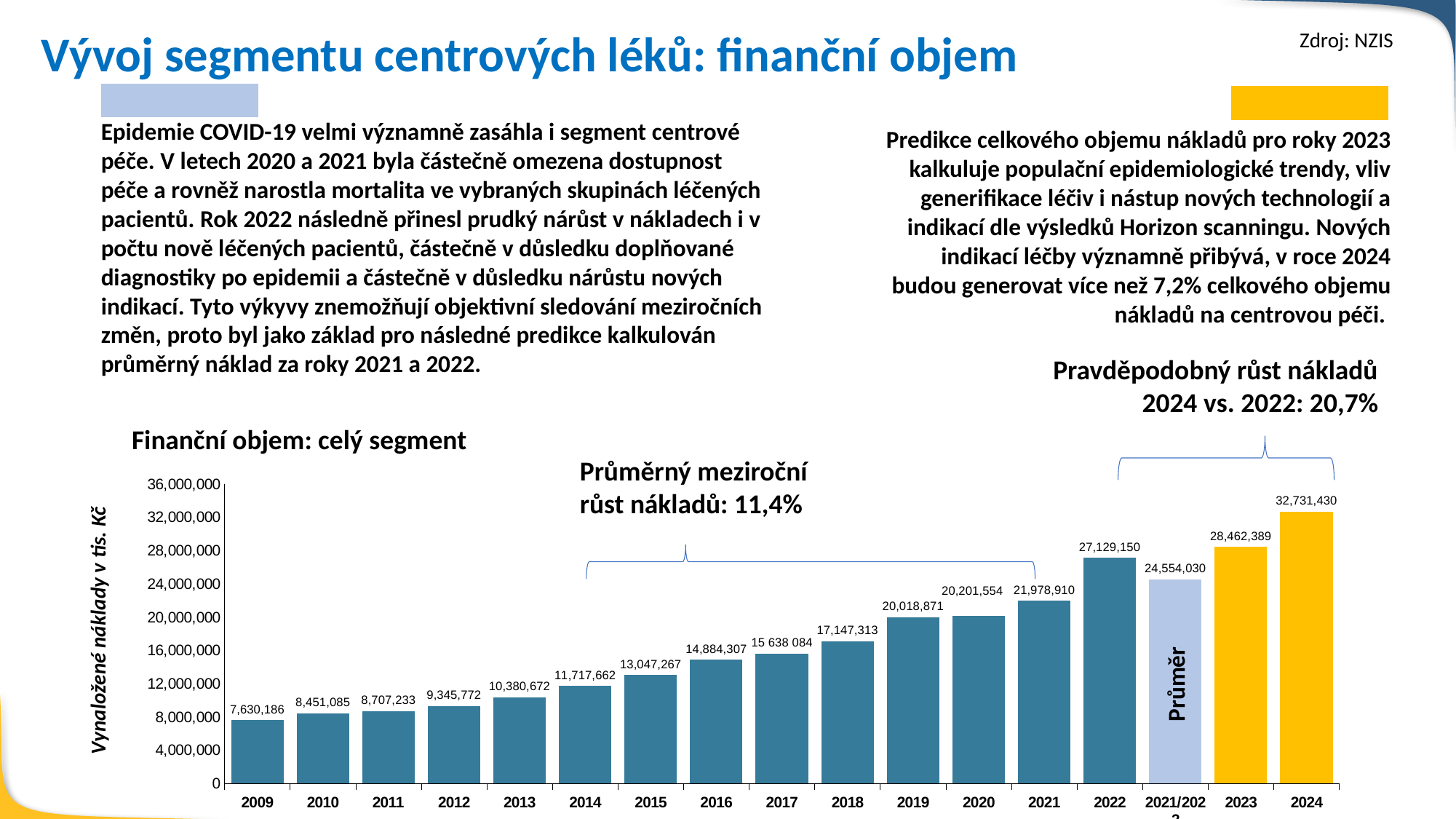
What kind of chart is shown on the slide? Bar chart Which year has the lowest value in the chart? 2009 What is the value shown for the 2021/2022 average bar (Průměr)? 24,554,030 What is the difference between the values for 2024 and 2022? 5,602,280 Which year has the highest value in the chart? 2024 What is the value for 2022 in the chart? 27,129,150 What is the label of the vertical axis of the chart? Vynaložené náklady v tis. Kč Which is larger, the value for 2019 or the value for 2020? 2020 What is the value for 2009 in the chart 'Finanční objem: celý segment'? 7,630,186 What is the value for 2017 in the chart? 15 638 084 Do the values rise or fall from 2009 to 2024? Rise How many bars are plotted in the chart? 17